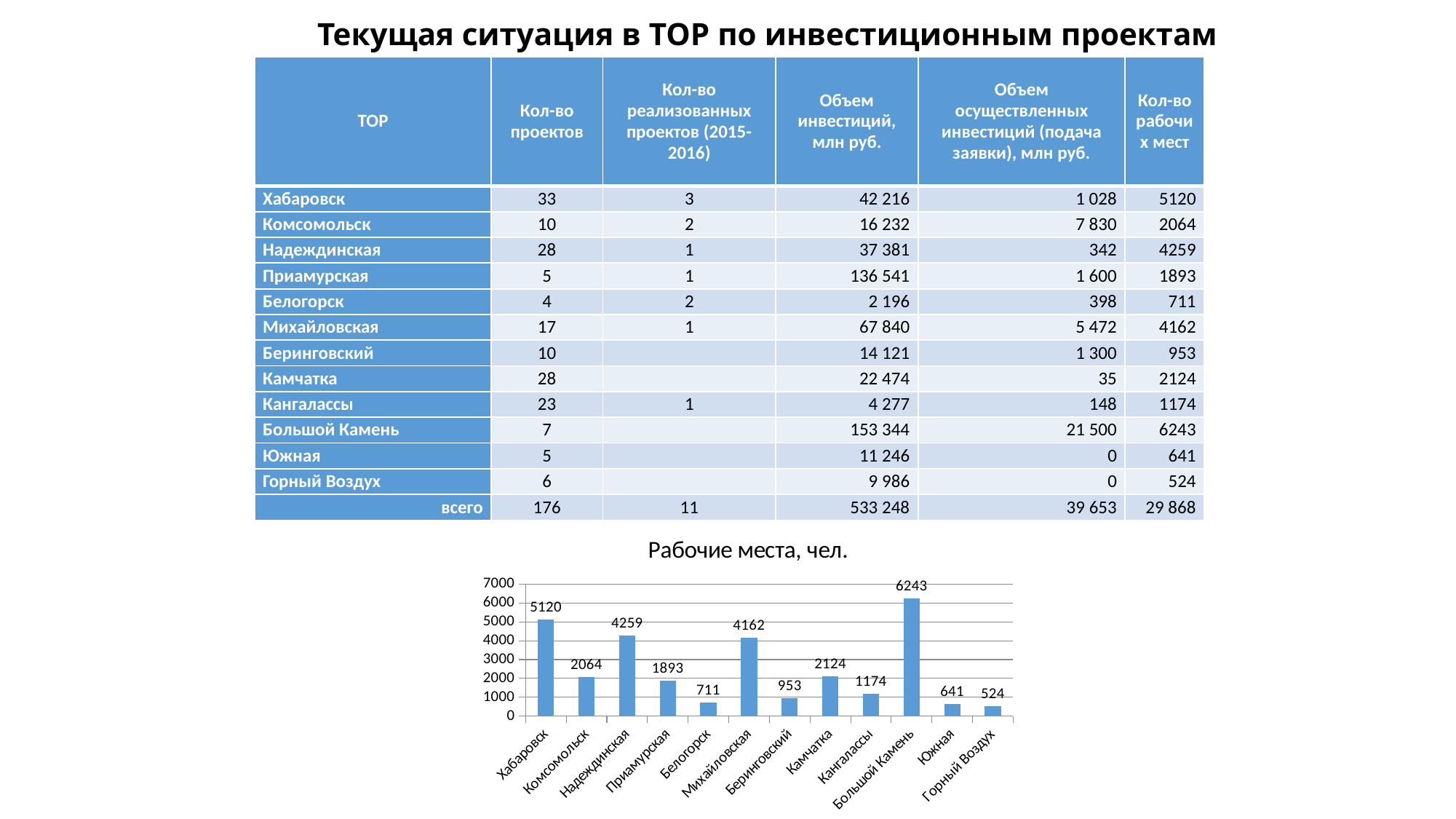
Which category has the lowest value in the chart "Рабочие места, чел."? Горный Воздух Which category has the highest value in the chart "Рабочие места, чел."? Большой Камень In the chart "Рабочие места, чел.", is the value for Приамурская greater or less than 2000? less What is the value for Кангалассы in the chart "Рабочие места, чел."? 1174 In the chart "Рабочие места, чел.", what is the difference between the values for Камчатка and Комсомольск? 60 How many categories are shown on the x axis of the chart "Рабочие места, чел."? 12 In the chart "Рабочие места, чел.", which is larger: the value for Камчатка or the value for Кангалассы? Камчатка In the chart "Рабочие места, чел.", what is the difference between the values for Большой Камень and Хабаровск? 1123 What is the value for Беринговский in the chart "Рабочие места, чел."? 953 What kind of chart is "Рабочие места, чел."? bar chart What is the value for Хабаровск in the chart "Рабочие места, чел."? 5120 What is the title of the chart on the slide? Рабочие места, чел.